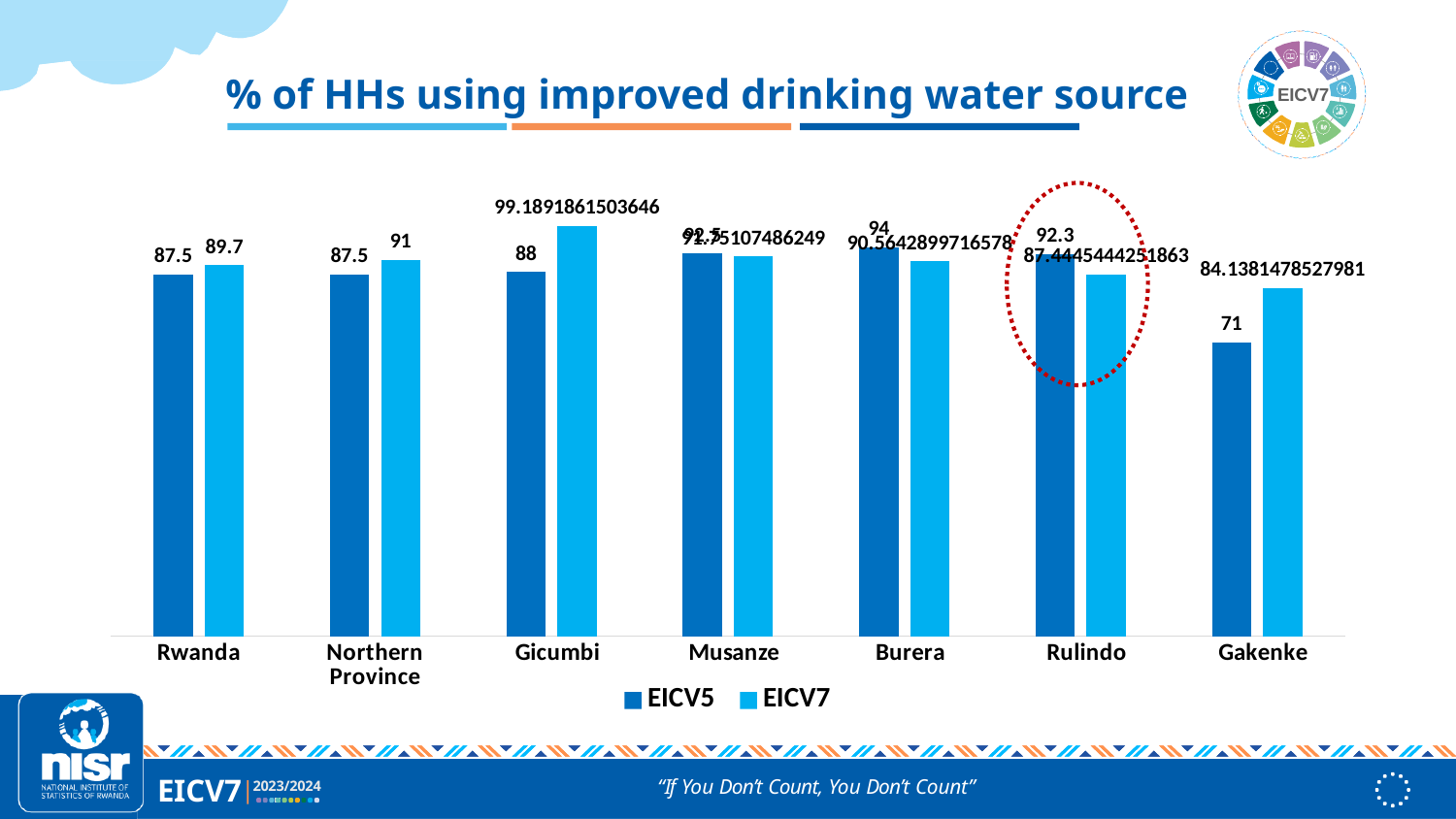
What is the EICV7 value for Northern Province? 91 What kind of chart is shown on the slide? bar chart How many series does the legend list? 2 What is the difference between the EICV7 and EICV5 values for Northern Province? 3.5 What is the EICV5 value for Burera? 94 What is the EICV7 value for Rwanda? 89.7 How many categories are shown on the x axis? 7 For Burera, which is larger, the EICV5 value or the EICV7 value? EICV5 Which category has the lowest EICV5 value? Gakenke What is the difference between the EICV7 and EICV5 values for Rwanda? 2.2 Which category has the highest EICV7 value? Gicumbi What is the EICV5 value for Gakenke? 71